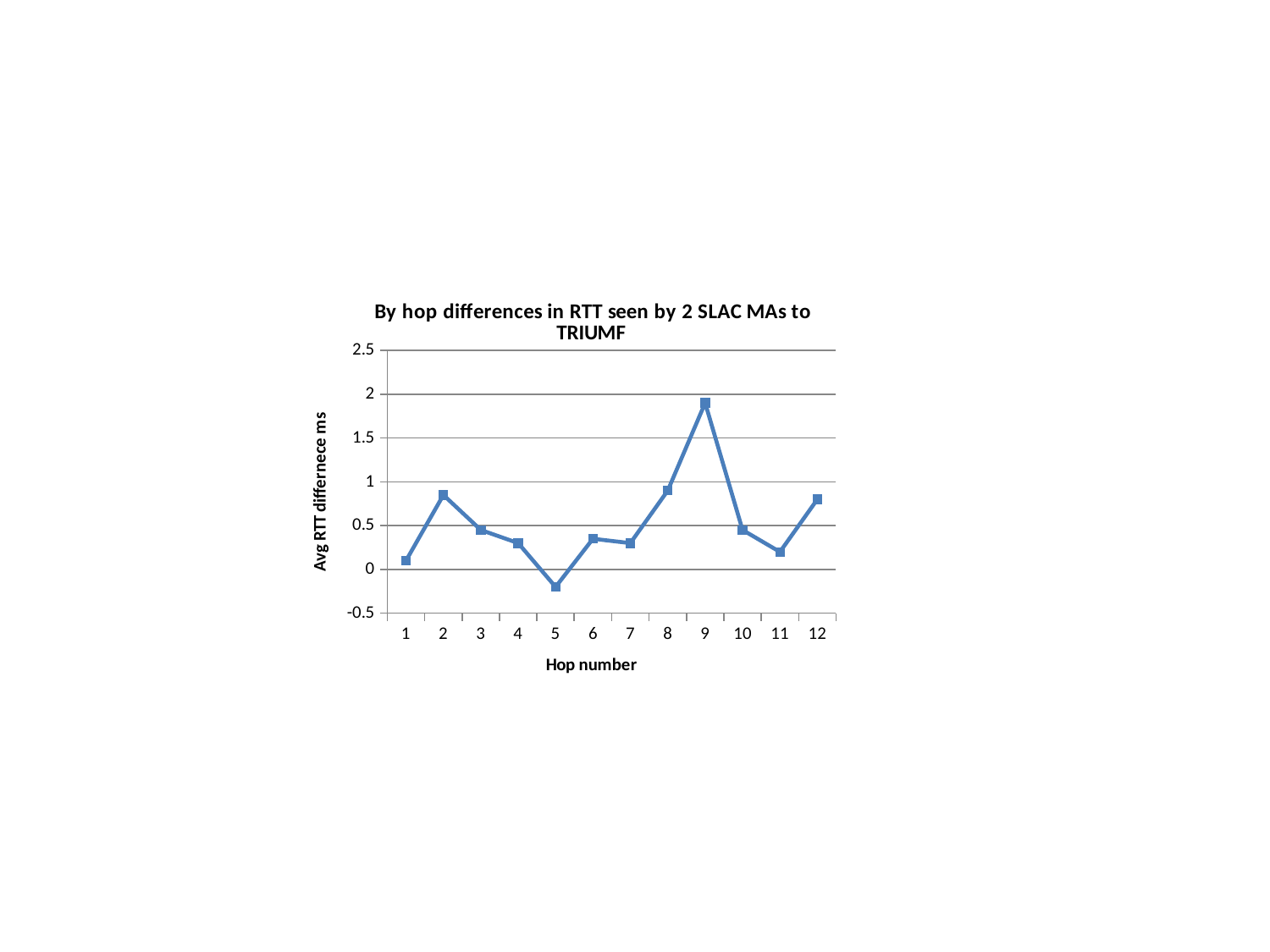
Is the value for hop 9 greater or less than 1.5? greater Is the value for hop 2 greater or less than 0.5? greater Which hop number has the highest average RTT difference? 9 Is the value for hop 5 greater or less than 0? less What kind of chart is shown on the slide? line chart Which has a larger average RTT difference, hop 8 or hop 11? hop 8 Which hop number has the lowest average RTT difference? 5 What is the title of the chart? By hop differences in RTT seen by 2 SLAC MAs to TRIUMF What is the label of the y axis? Avg RTT differnece ms Does the average RTT difference rise or fall from hop 9 to hop 10? fall How many hop numbers are plotted on the x axis? 12